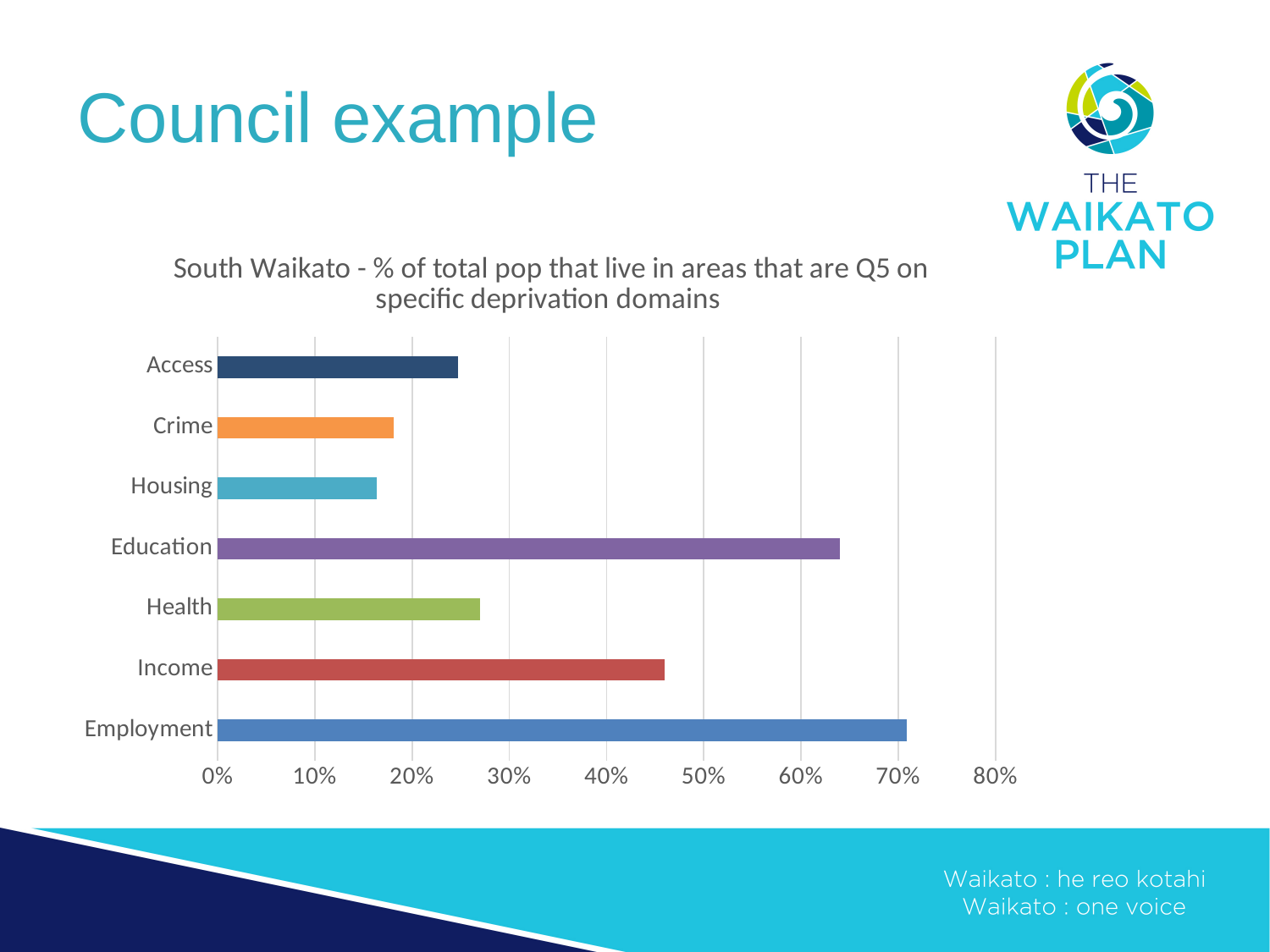
What type of chart is shown on the slide? bar chart Which category has the highest value? Employment Is the value for Crime greater or less than 20%? less Is the value for Income greater or less than 50%? less How many categories are shown in the chart? 7 What is the title of the chart? South Waikato - % of total pop that live in areas that are Q5 on specific deprivation domains Is the value for Education greater or less than 60%? greater Which is larger, the value for Education or the value for Health? Education Which category has the lowest value? Housing Which is larger, the value for Income or the value for Access? Income